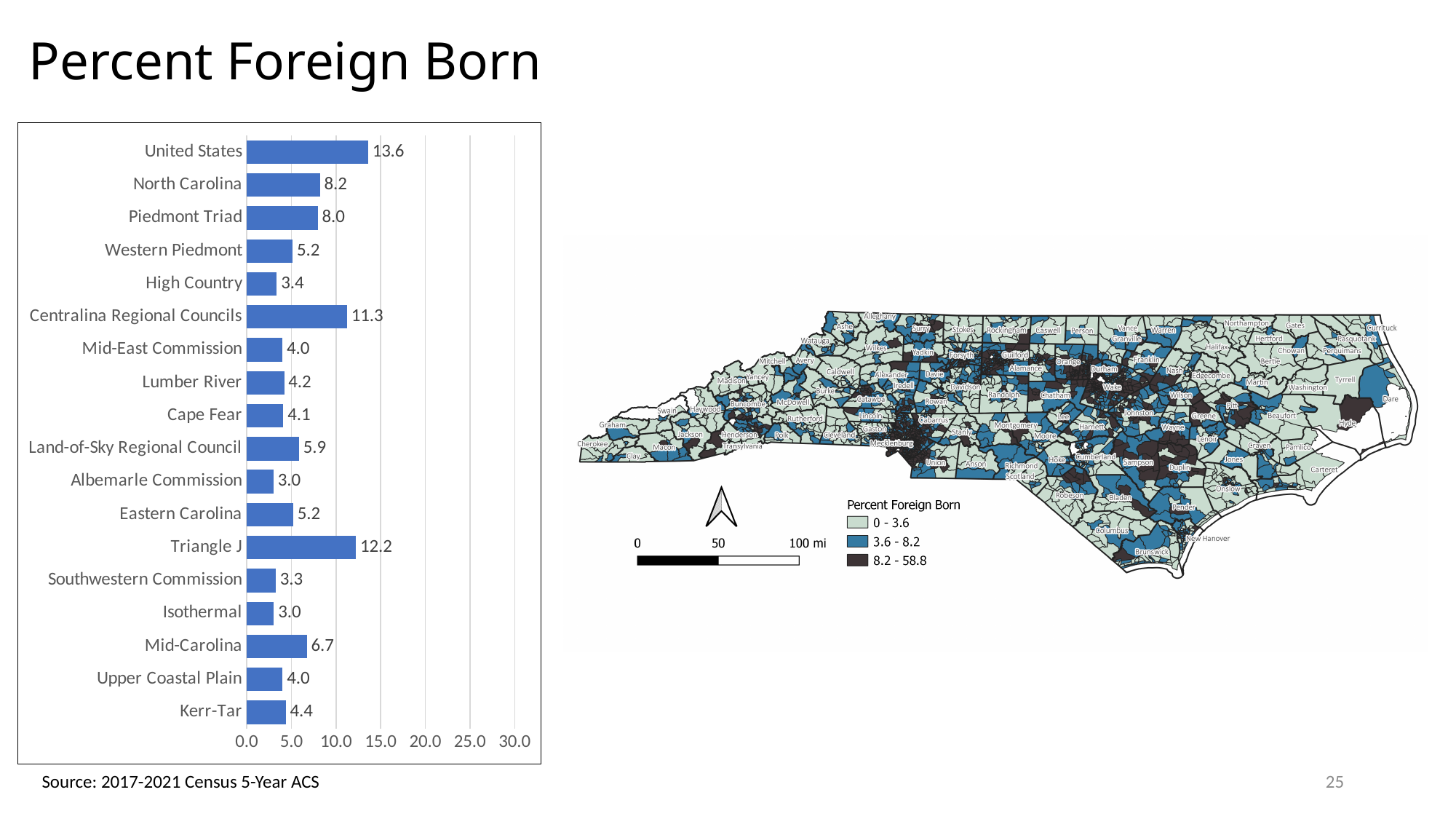
Is the value for Mid-Carolina greater or less than 5.0? greater What is the percent foreign born value shown for North Carolina? 8.2 How many categories are shown in the bar chart? 18 Which category has the highest value in the bar chart? United States What kind of chart is used to show the percent foreign born values? Bar chart What value is shown for Centralina Regional Councils? 11.3 Which has a larger value, Piedmont Triad or Western Piedmont? Piedmont Triad What value is shown for Mid-Carolina? 6.7 What is the difference between the United States value and the North Carolina value? 5.4 What is the title of the slide? Percent Foreign Born Which North Carolina region (excluding United States and North Carolina) has the highest value? Triangle J What is the difference between the Triangle J value and the Centralina Regional Councils value? 0.9